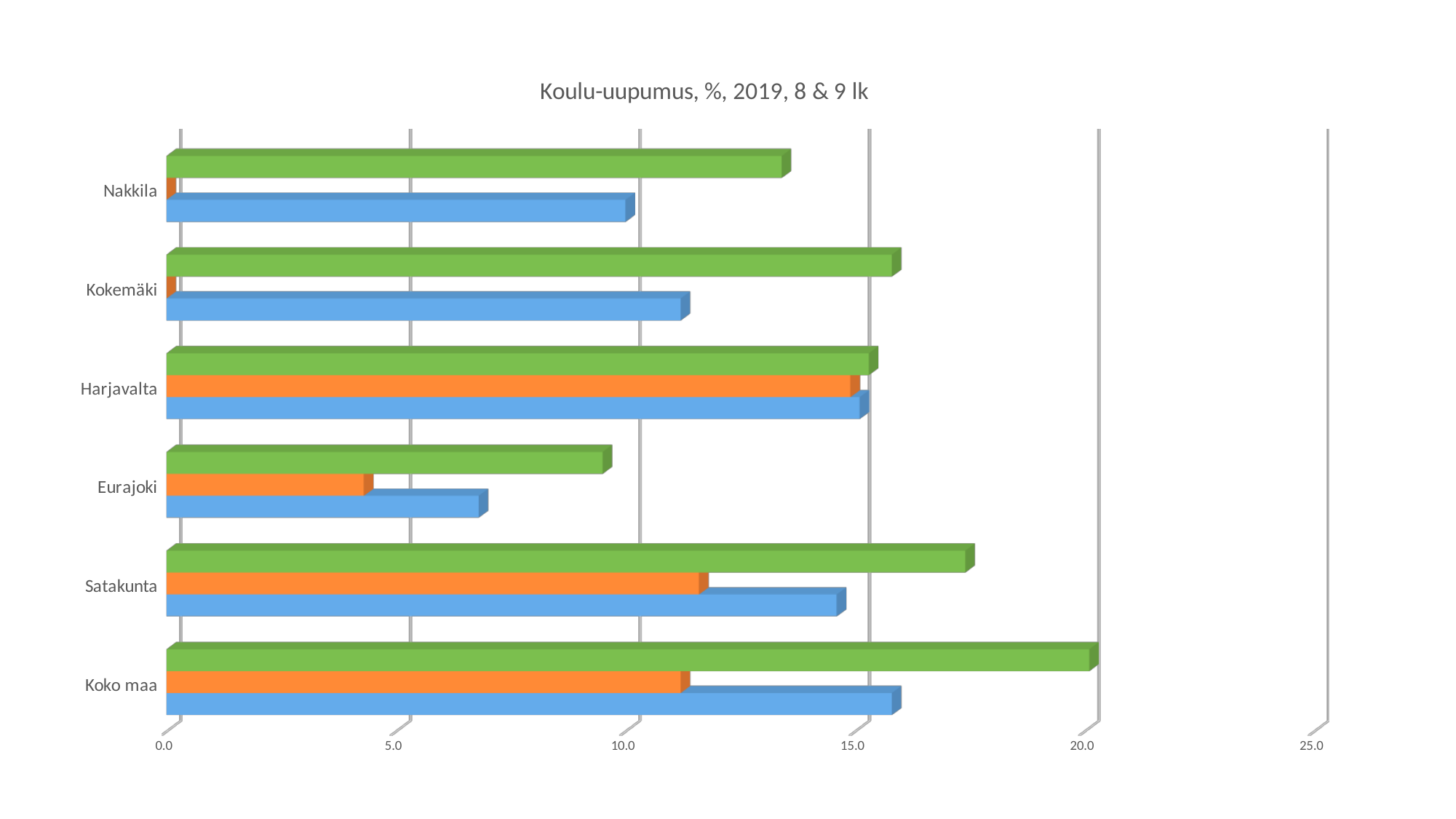
Which category has the shortest blue bar? Eurajoki What is the title of the chart? Koulu-uupumus, %, 2019, 8 & 9 lk Which category has the shortest green bar? Eurajoki How many bars are plotted for each category in the chart? 3 Is the orange bar for Eurajoki greater or less than 5.0? less Which category has the longest orange bar? Harjavalta Which is larger, the green bar for Satakunta or the green bar for Nakkila? Satakunta How many categories are shown on the vertical axis of the chart? 6 What kind of chart is shown on the slide? bar chart Is the green bar for Satakunta greater or less than 15.0? greater Is the blue bar for Eurajoki greater or less than 10.0? less Which category has the longest green bar? Koko maa